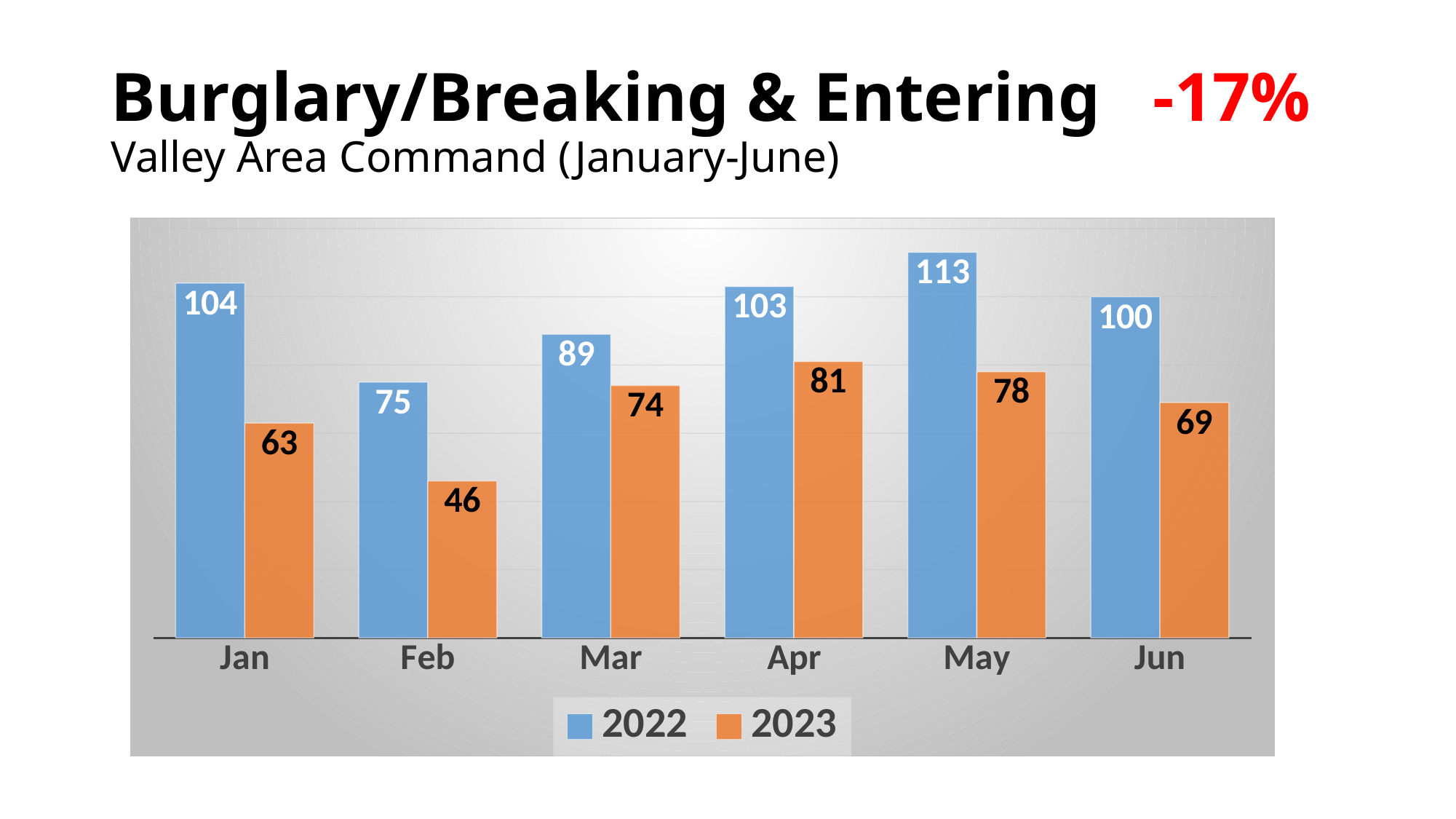
Which is larger in Mar, the 2022 value or the 2023 value? 2022 What kind of chart is shown on the slide? Bar chart What is the value for 2023 in Feb? 46 What is the value for 2023 in Apr? 81 How many series does the legend list? 2 Which month has the lowest value for 2023? Feb How many months are shown on the x axis? 6 Which series is shown in orange? 2023 What is the difference between the 2022 and 2023 values in Jan? 41 What percentage change is shown in red next to the title? -17% Which month has the highest value for 2022? May What is the value for 2022 in May? 113